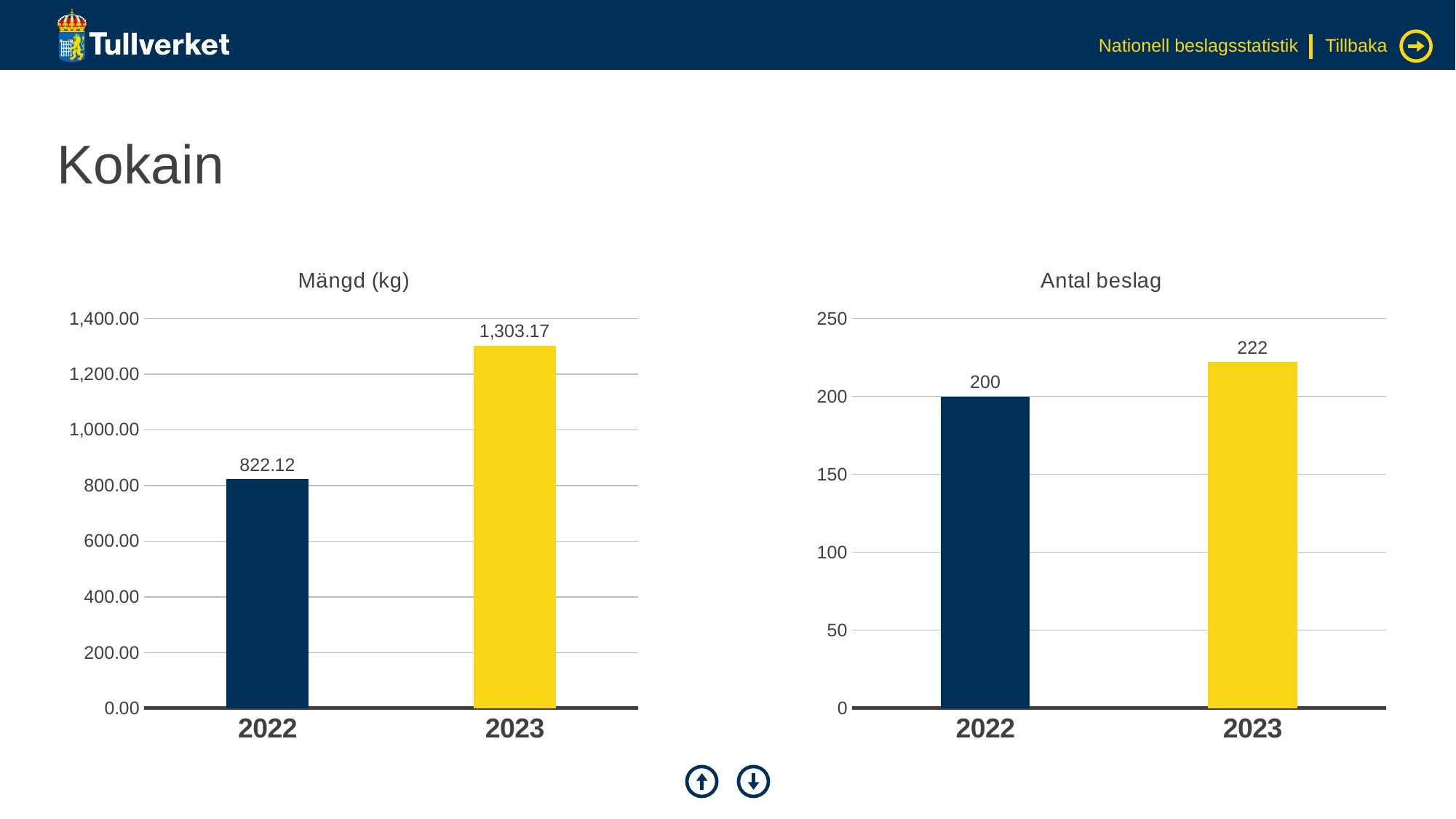
In the 'Mängd (kg)' chart, is the value for 2022 greater or less than 1,000.00? less In the 'Mängd (kg)' chart, what is the value for 2022? 822.12 How many categories does the 'Antal beslag' chart show? 2 What kind of chart is the 'Mängd (kg)' chart? bar chart In the 'Antal beslag' chart, which year has the lowest value? 2022 In the 'Antal beslag' chart, do the values rise or fall from 2022 to 2023? rise In the 'Antal beslag' chart, what is the value for 2023? 222 In the 'Mängd (kg)' chart, what is the value for 2023? 1,303.17 In the 'Antal beslag' chart, what is the difference between the values for 2023 and 2022? 22 In the 'Antal beslag' chart, what is the value for 2022? 200 In the 'Mängd (kg)' chart, what is the difference between the values for 2023 and 2022? 481.05 In the 'Mängd (kg)' chart, which year has the highest value? 2023